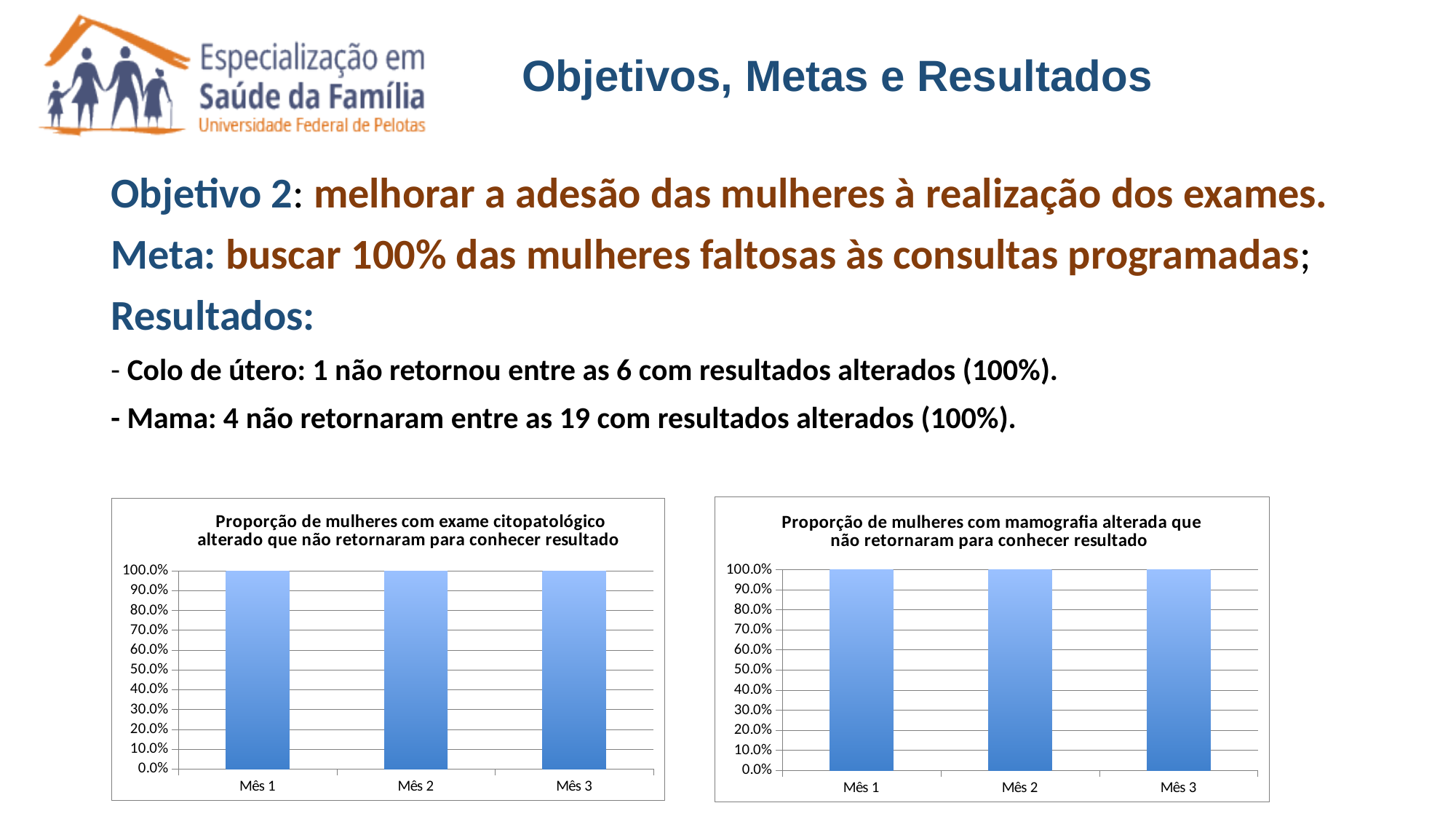
In the left chart (exame citopatológico), is the value for Mês 2 greater or less than 50.0%? greater In the right chart (mamografia alterada), how many bars are plotted? 3 In the right chart (mamografia alterada), do the values rise, fall, or stay the same across the three months? Stay the same What is the title of the left chart? Proporção de mulheres com exame citopatológico alterado que não retornaram para conhecer resultado What kind of chart is the right chart (mamografia alterada)? Bar chart In the left chart (Proporção de mulheres com exame citopatológico alterado que não retornaram para conhecer resultado), what is the value for Mês 1? 100.0% What kind of chart is the left chart (exame citopatológico)? Bar chart In the left chart (exame citopatológico), do the values rise, fall, or stay the same from Mês 1 to Mês 3? Stay the same In the right chart (Proporção de mulheres com mamografia alterada que não retornaram para conhecer resultado), what is the value for Mês 3? 100.0% In the right chart (mamografia alterada), is the value for Mês 1 greater or less than 90.0%? greater In the right chart (mamografia alterada), what is the difference between the values for Mês 1 and Mês 2? 0.0% In the left chart (exame citopatológico), how many categories are shown on the x axis? 3